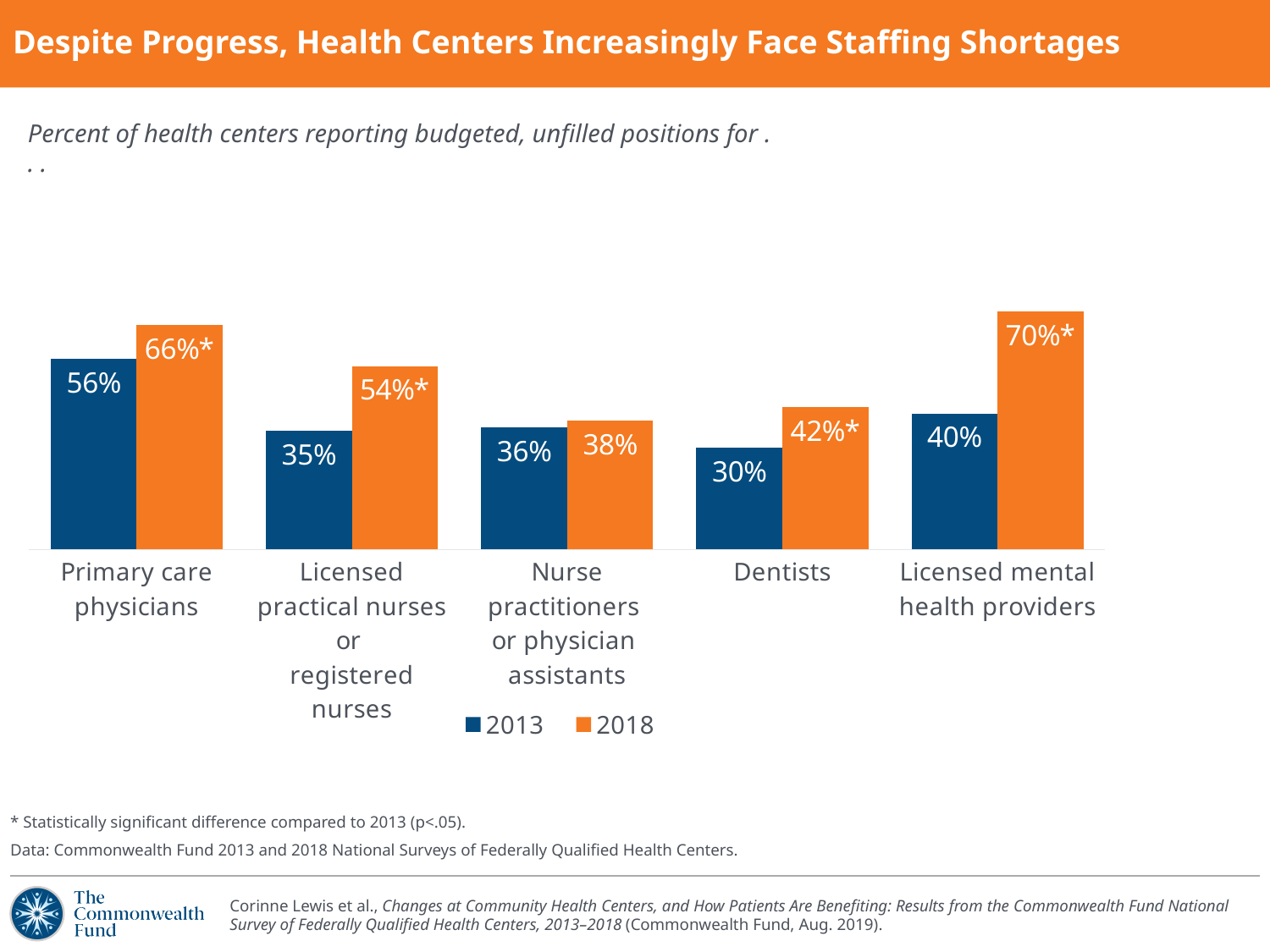
Which is larger: the 2013 value for primary care physicians or the 2018 value for dentists? 2013 value for primary care physicians Which category has the highest 2018 value? Licensed mental health providers What kind of chart is shown on the slide? Bar chart What percent of health centers reported budgeted, unfilled positions for primary care physicians in 2013? 56% What is the difference between the 2018 and 2013 values for licensed mental health providers? 30 percentage points What is the 2018 value for dentists? 42%* What is the 2018 value for licensed mental health providers? 70%* Which category has the lowest 2013 value? Dentists How many categories are shown on the x axis? 5 How many series does the legend list? 2 What is the difference between the 2018 and 2013 values for licensed practical nurses or registered nurses? 19 percentage points What is the 2013 value for nurse practitioners or physician assistants? 36%